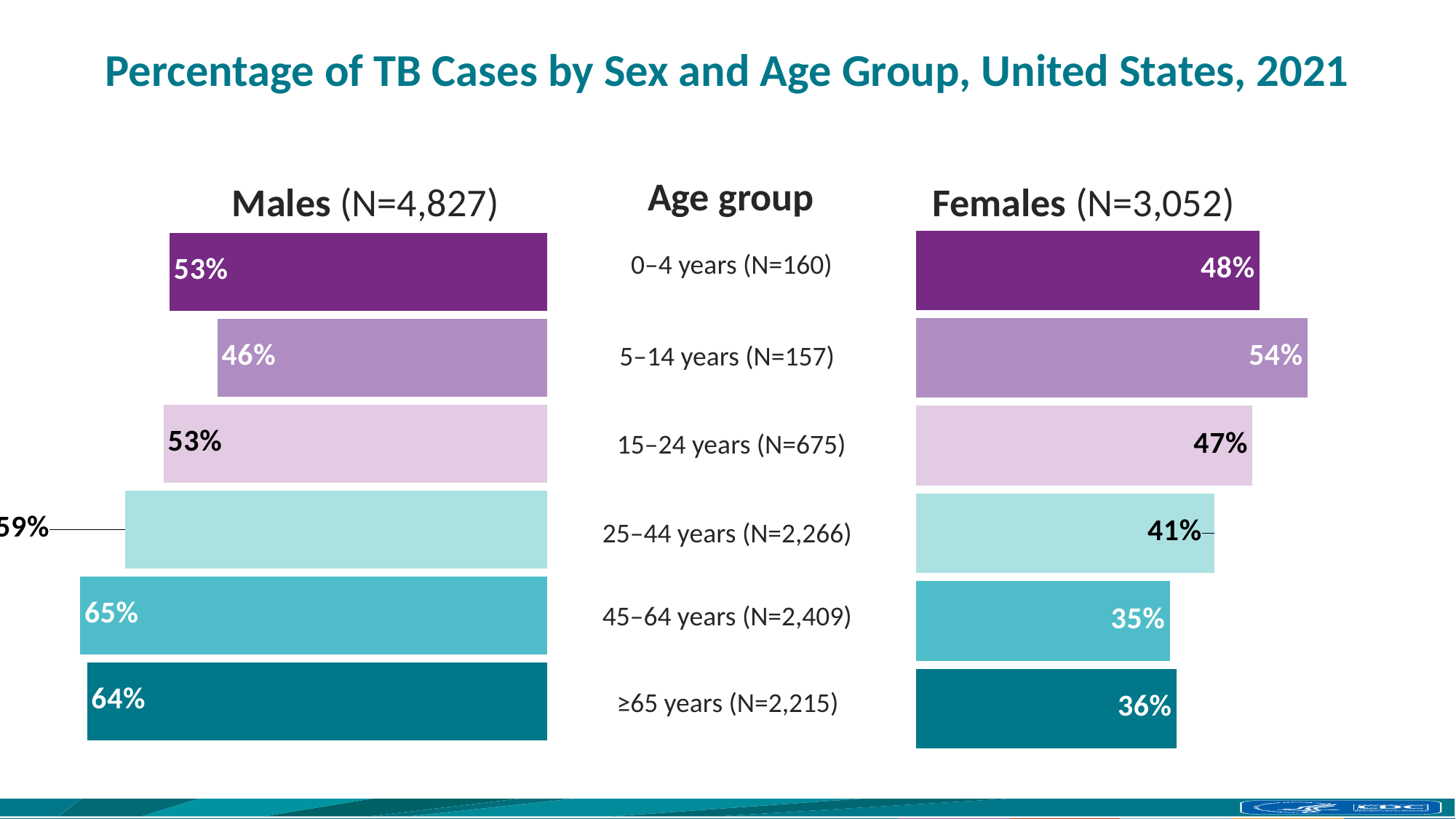
Which age group has the lowest percentage of male TB cases? 5–14 years What is the difference between the male and female percentages in the ≥65 years age group? 28 percentage points How many age groups are shown on the chart? 6 What percentage of TB cases in the 45–64 years age group were males? 65% Which age group has the lowest percentage of female TB cases? 45–64 years What is the title of the chart? Percentage of TB Cases by Sex and Age Group, United States, 2021 What type of chart is shown on the slide? Bar chart In the 5–14 years age group, is the male or female percentage larger? Female What percentage of TB cases in the 5–14 years age group were females? 54% Which age group has the highest percentage of male TB cases? 45–64 years What percentage of TB cases in the 25–44 years age group were females? 41% What is the total number of male TB cases (N) shown in the Males heading? 4,827